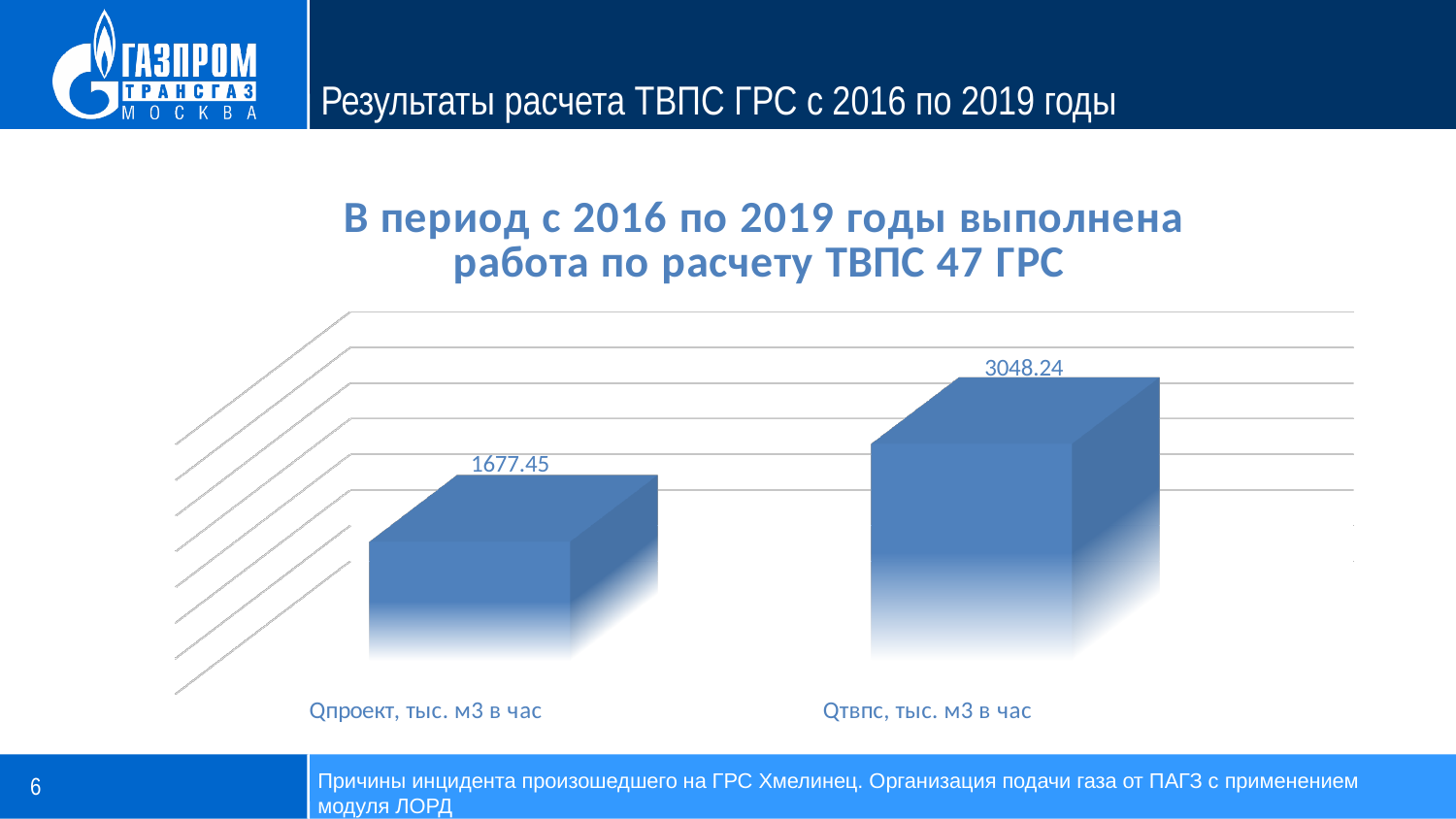
Which category has the highest value? Qтвпс, тыс. м3 в час How many categories are shown in the chart? 2 What is the label of the left-hand category in the chart? Qпроект, тыс. м3 в час What is the value for Qтвпс, тыс. м3 в час? 3048.24 What colour are the bars in the chart? Blue What is the difference between the values for Qтвпс, тыс. м3 в час and Qпроект, тыс. м3 в час? 1370.79 Do the values rise or fall from the left category to the right category? Rise Which is larger, the value for Qпроект, тыс. м3 в час or the value for Qтвпс, тыс. м3 в час? Qтвпс, тыс. м3 в час Which category has the lowest value? Qпроект, тыс. м3 в час What is the value for Qпроект, тыс. м3 в час? 1677.45 What kind of chart is shown on the slide? Bar chart